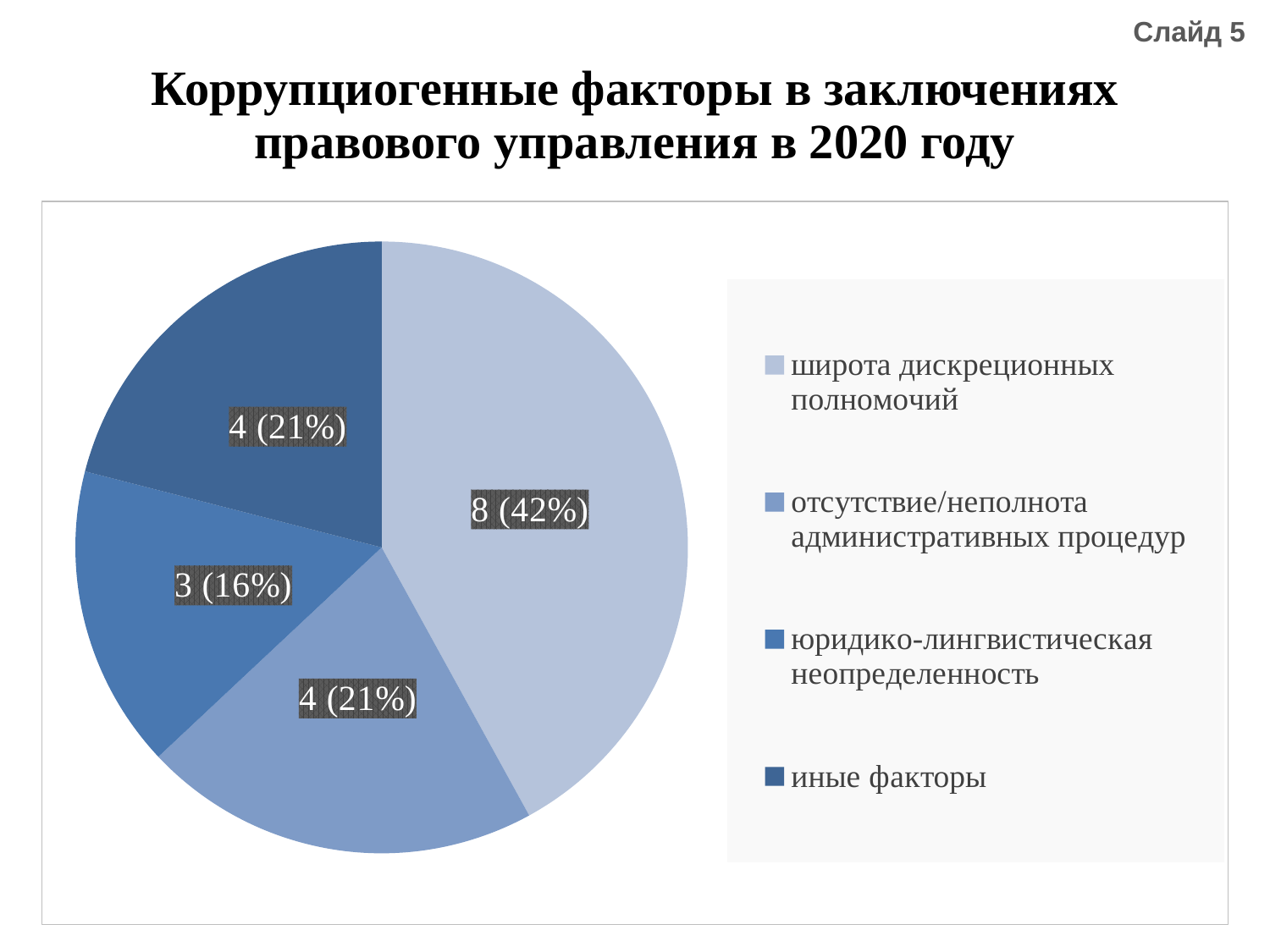
How many entries does the legend list? 4 Which category has the largest slice of the pie? широта дискреционных полномочий What is the value for «широта дискреционных полномочий»? 8 (42%) What is the difference between the count for «широта дискреционных полномочий» and the count for «юридико-лингвистическая неопределенность»? 5 What share of the pie does «отсутствие/неполнота административных процедур» take? 21% What is the value for «юридико-лингвистическая неопределенность»? 3 (16%) How many slices does the pie chart have? 4 Which is larger: the value for «широта дискреционных полномочий» or the value for «иные факторы»? широта дискреционных полномочий What is the value for «иные факторы»? 4 (21%) What is the title of the chart on the slide? Коррупциогенные факторы в заключениях правового управления в 2020 году What kind of chart is shown on the slide? pie chart Which category has the smallest slice of the pie? юридико-лингвистическая неопределенность